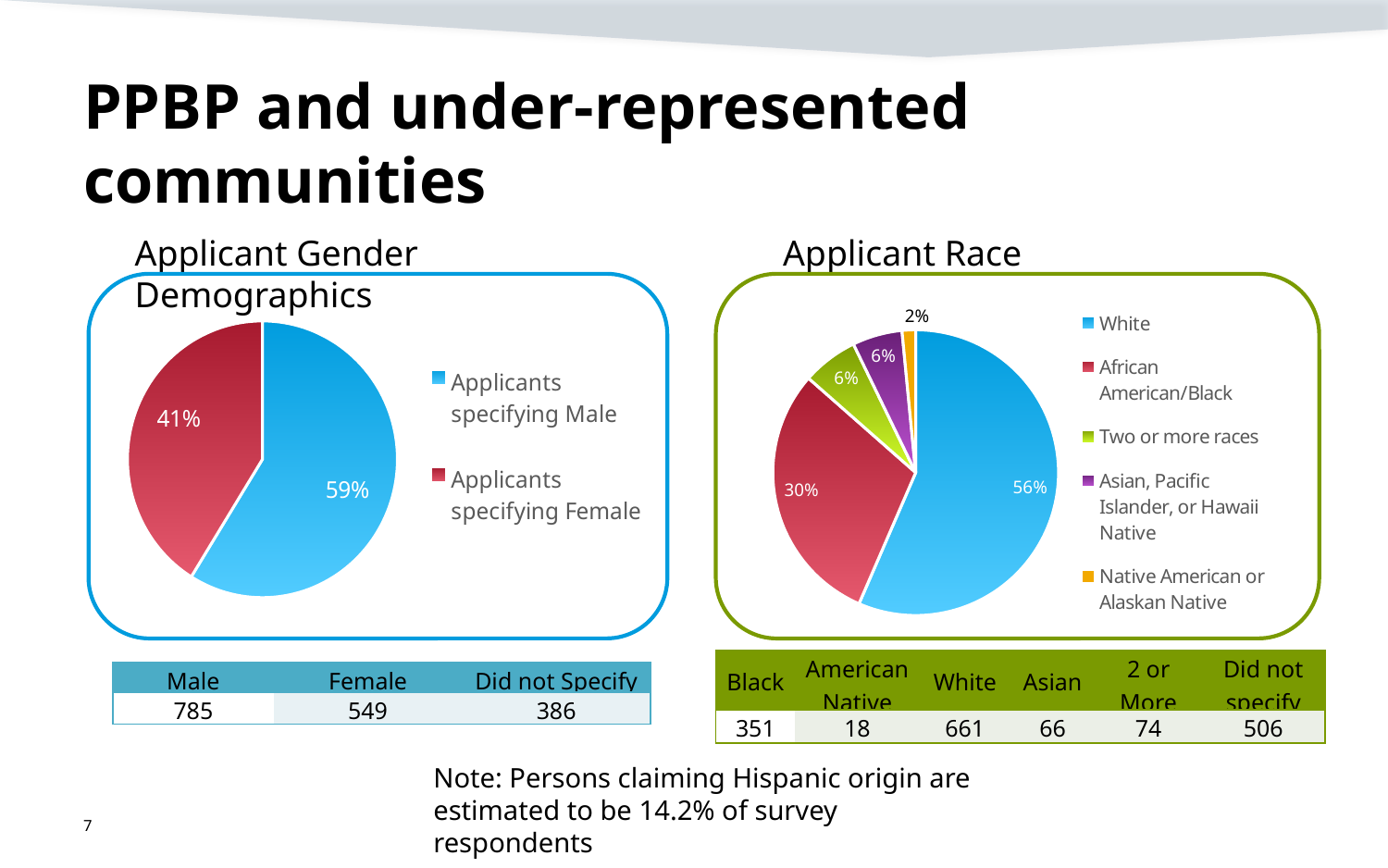
In the Applicant Gender Demographics chart, what is the difference in percentage points between the Male and Female slices? 18 In the Applicant Race chart, what share of applicants are Native American or Alaskan Native? 2% In the Applicant Race chart, what colour is the slice for Two or more races? green In the Applicant Race chart, what share of applicants are White? 56% In the Applicant Gender Demographics chart, which slice is larger, Applicants specifying Male or Applicants specifying Female? Applicants specifying Male How many entries does the legend of the Applicant Gender Demographics chart list? 2 In the Applicant Race chart, which category has the smallest slice? Native American or Alaskan Native In the Applicant Gender Demographics chart, what share of applicants specified Male? 59% How many categories does the legend of the Applicant Race chart list? 5 What type of chart is the Applicant Gender Demographics chart? pie chart